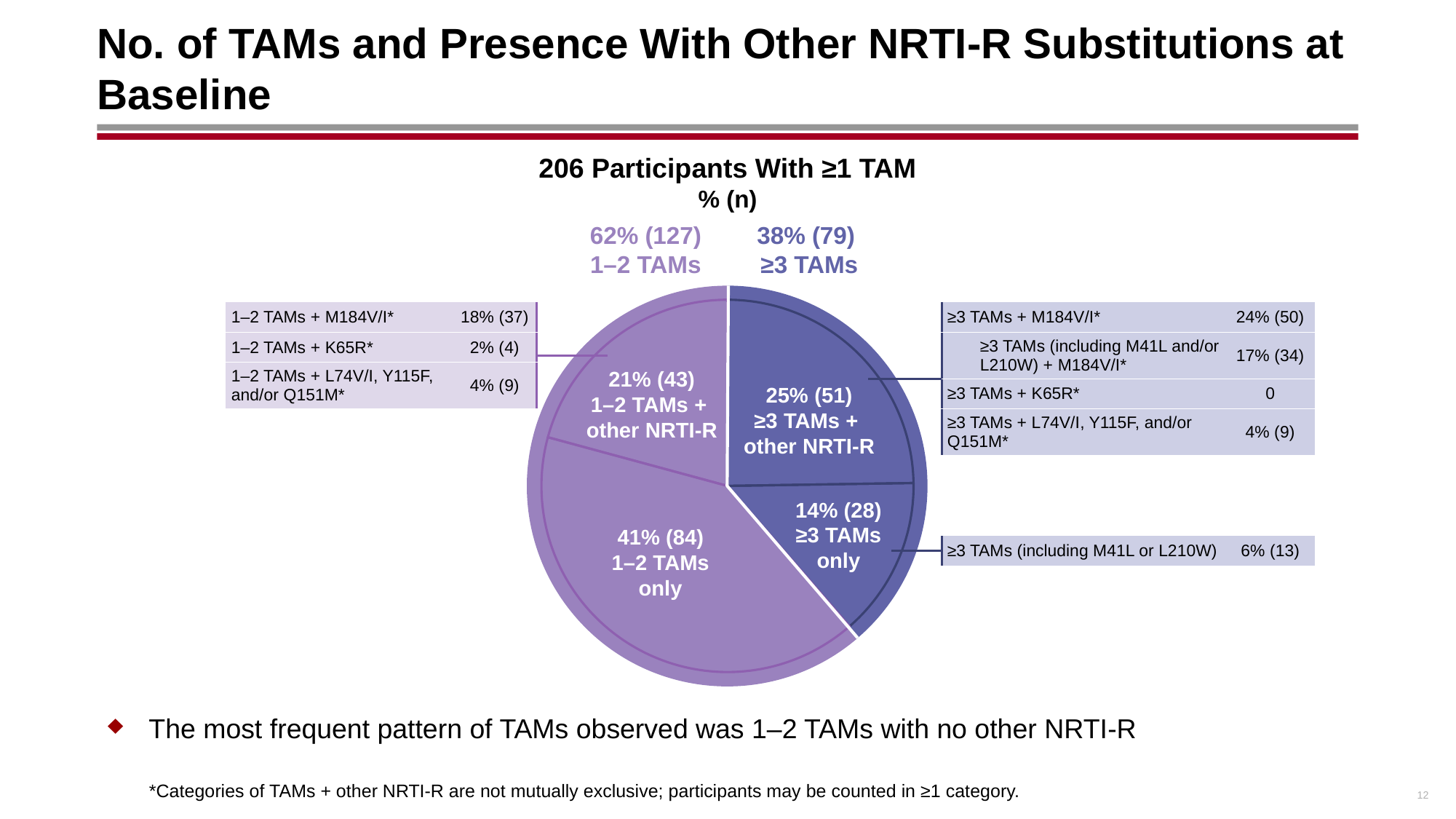
What percentage of participants had 1–2 TAMs only? 41% (84) What percentage of participants had ≥3 TAMs only? 14% (28) What kind of chart is shown on the slide? Pie chart In the side table, what is the value for ≥3 TAMs + K65R*? 0 What is the title above the pie chart? 206 Participants With ≥1 TAM % (n) How many participants had ≥3 TAMs + other NRTI-R? 51 Which slice of the pie chart is the smallest? ≥3 TAMs only How many slices does the pie chart have? 4 Which is larger: the share for ≥3 TAMs + other NRTI-R or the share for 1–2 TAMs + other NRTI-R? ≥3 TAMs + other NRTI-R What percentage and number of participants had ≥3 TAMs in total? 38% (79) Which slice of the pie chart is the largest? 1–2 TAMs only What is the difference in number of participants between 1–2 TAMs only and 1–2 TAMs + other NRTI-R? 41